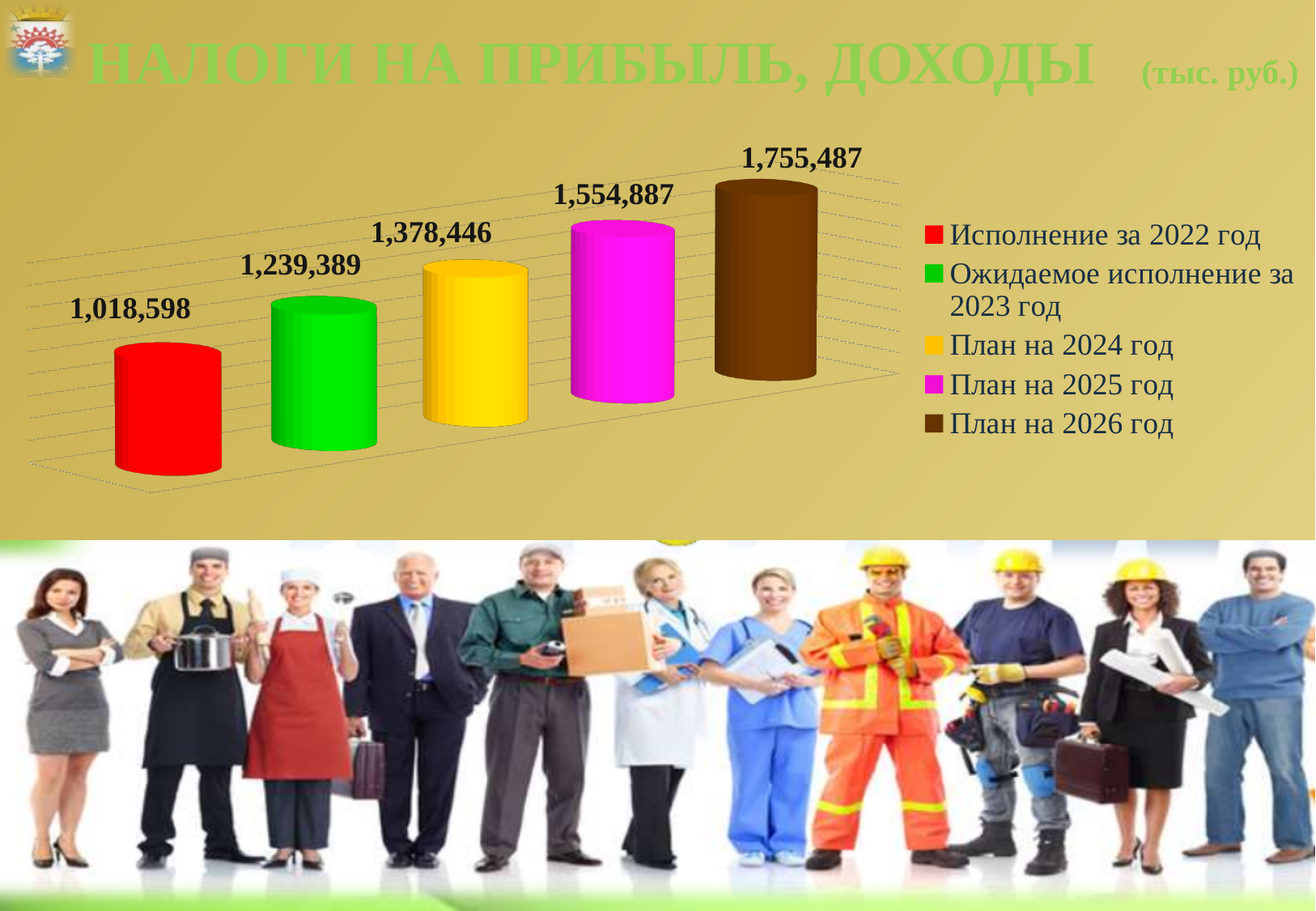
What is the value for «План на 2024 год»? 1,378,446 What is the value for «Исполнение за 2022 год»? 1,018,598 What is the difference between the value for «План на 2026 год» and the value for «Исполнение за 2022 год»? 736,889 Which is larger: the value for «План на 2025 год» or the value for «Ожидаемое исполнение за 2023 год»? План на 2025 год How many entries does the legend list? 5 How many bars are plotted on the chart? 5 Which legend entry has the highest value? План на 2026 год What is the value for «План на 2026 год»? 1,755,487 What is the difference between the value for «План на 2025 год» and the value for «План на 2024 год»? 176,441 Which legend entry has the lowest value? Исполнение за 2022 год What is the value for «Ожидаемое исполнение за 2023 год»? 1,239,389 Do the values rise or fall from left to right across the bars? rise